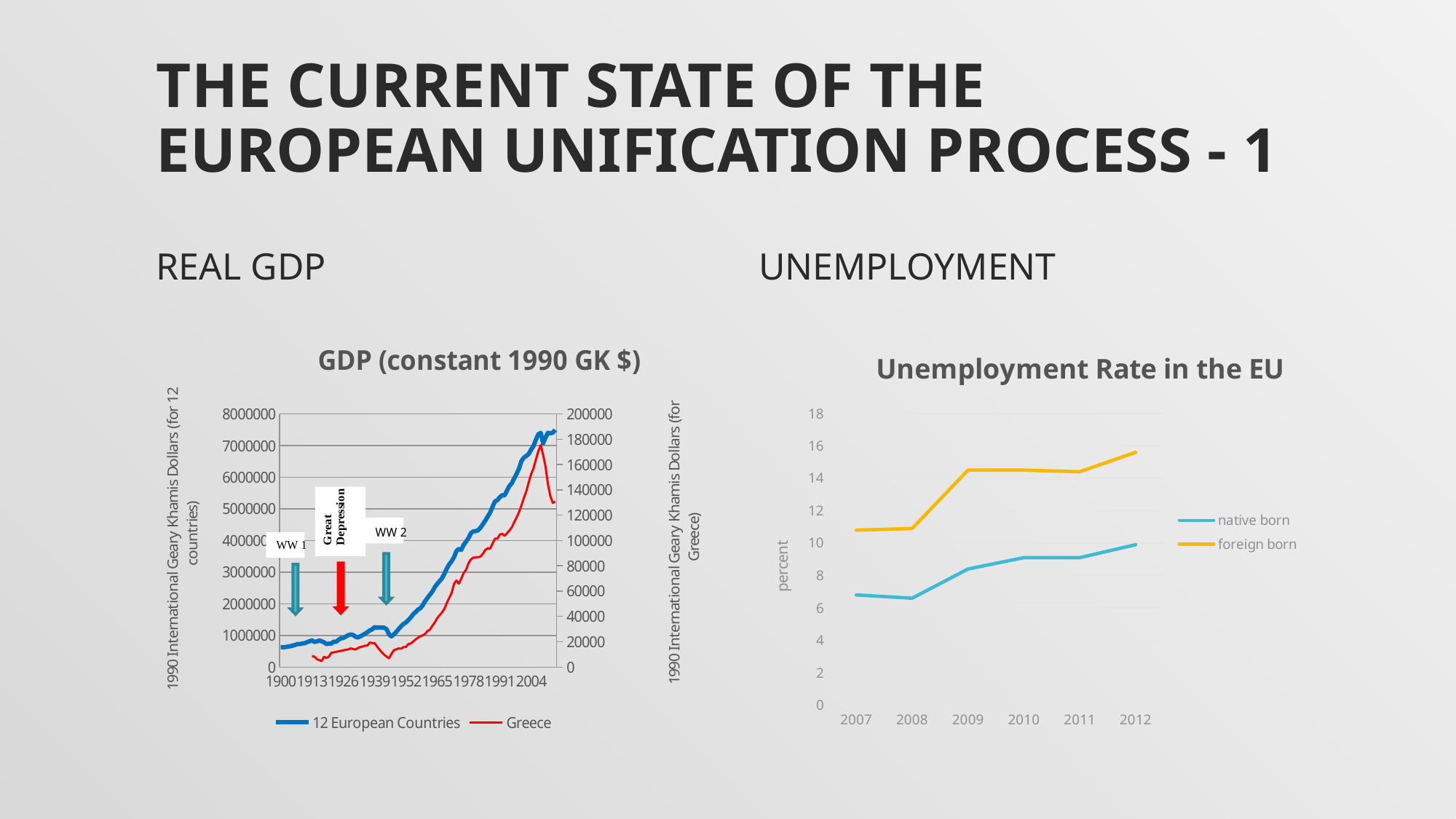
On the Unemployment Rate in the EU chart, does the native born series rise or fall from 2008 to 2012? rise On the GDP (constant 1990 GK $) chart, which series is drawn in red? Greece On the GDP (constant 1990 GK $) chart, is the value for 12 European Countries in 1900 greater or less than 1000000? less On the Unemployment Rate in the EU chart, is the value for native born in 2007 greater or less than 8? less On the GDP (constant 1990 GK $) chart, how many series does the legend list? 2 On the Unemployment Rate in the EU chart, what type of chart is shown? line chart On the Unemployment Rate in the EU chart, is the value for foreign born in 2012 greater or less than 14? greater On the Unemployment Rate in the EU chart, how many series does the legend list? 2 On the Unemployment Rate in the EU chart, which series is higher in 2010, native born or foreign born? foreign born On the Unemployment Rate in the EU chart, how many years are shown on the x axis? 6 On the Unemployment Rate in the EU chart, what is the label of the y axis? percent